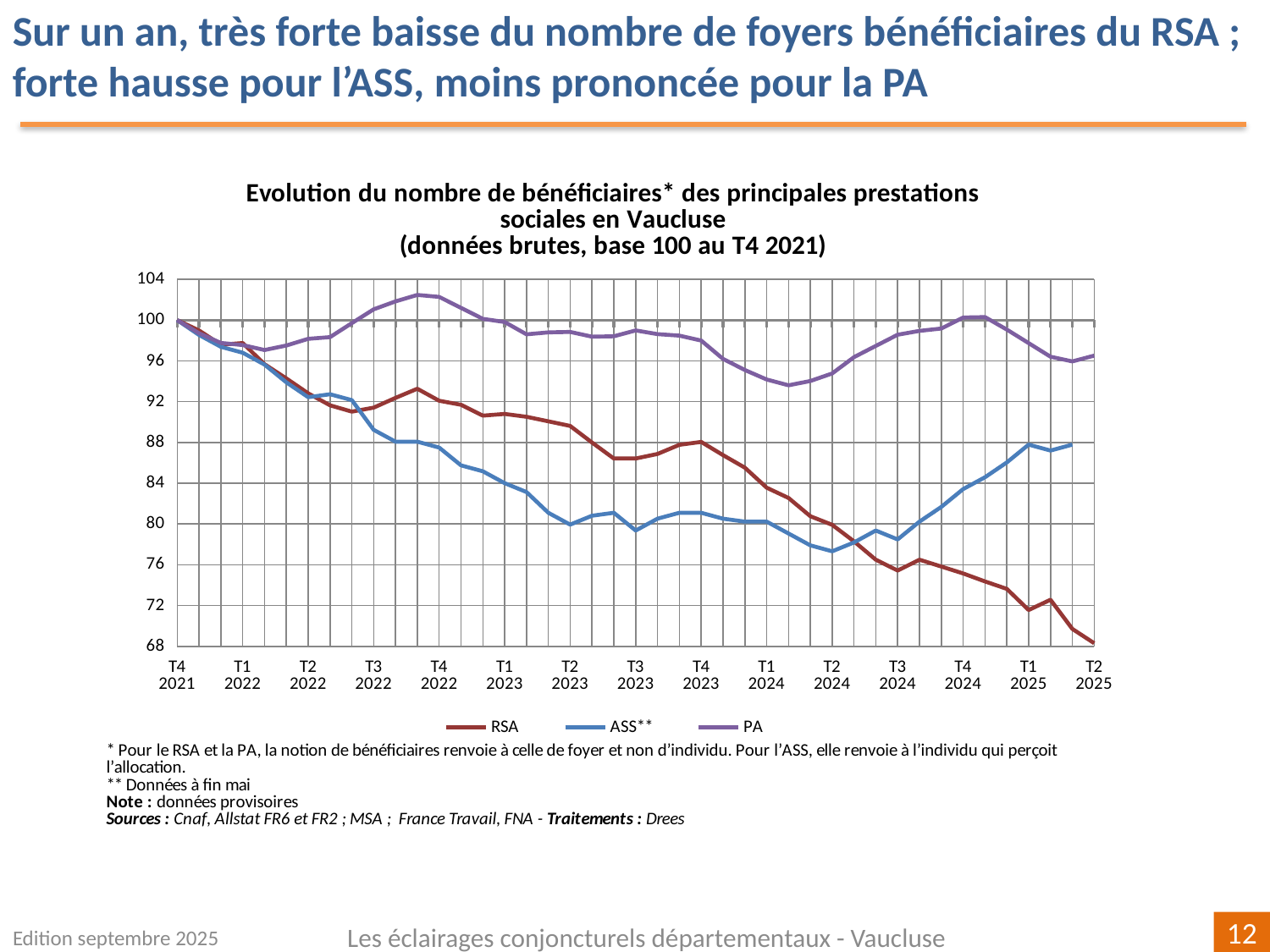
Is the value for ASS** at T2 2024 greater or less than 80? less How many series does the legend list? 3 Which series has the lowest value at T2 2025? RSA What kind of chart is shown on the slide? line chart Is the value for RSA at T2 2025 greater or less than 72? less Does the RSA series rise or fall overall from T4 2021 to T2 2025? fall Which series has the highest value at T2 2025? PA What is the value of the RSA series at T4 2021? 100 Which series are listed in the legend? RSA, ASS**, PA Is the value for PA at T4 2022 greater or less than 100? greater